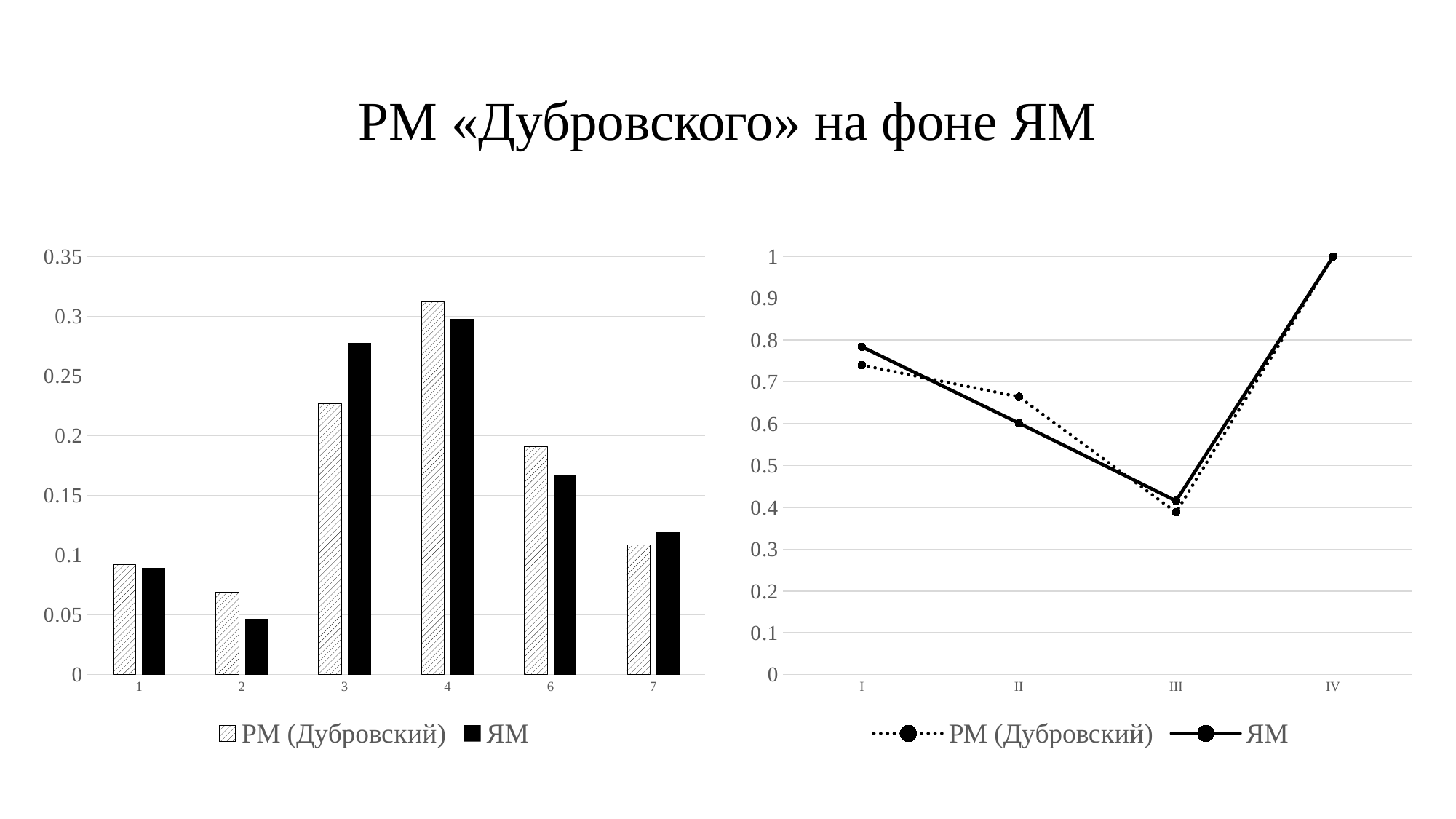
In the line chart on the right, how many points are plotted along the x axis for each series? 4 In the bar chart on the left, how many categories are shown on the x axis? 6 In the line chart on the right, at which category does РМ (Дубровский) reach its lowest value? III In the bar chart on the left, is the value for РМ (Дубровский) at category 4 greater or less than 0.3? greater What kind of chart is the chart on the left of the slide? bar chart In the bar chart on the left, which series has the larger value for category 3, РМ (Дубровский) or ЯМ? ЯМ In the bar chart on the left, which category has the highest value for РМ (Дубровский)? 4 In the bar chart on the left, how many series does the legend list? 2 In the line chart on the right, is the value for ЯМ at category II greater or less than 0.7? less In the line chart on the right, at which category does ЯМ reach its highest value? IV In the bar chart on the left, which category has the lowest value for ЯМ? 2 What kind of chart is the chart on the right of the slide? line chart